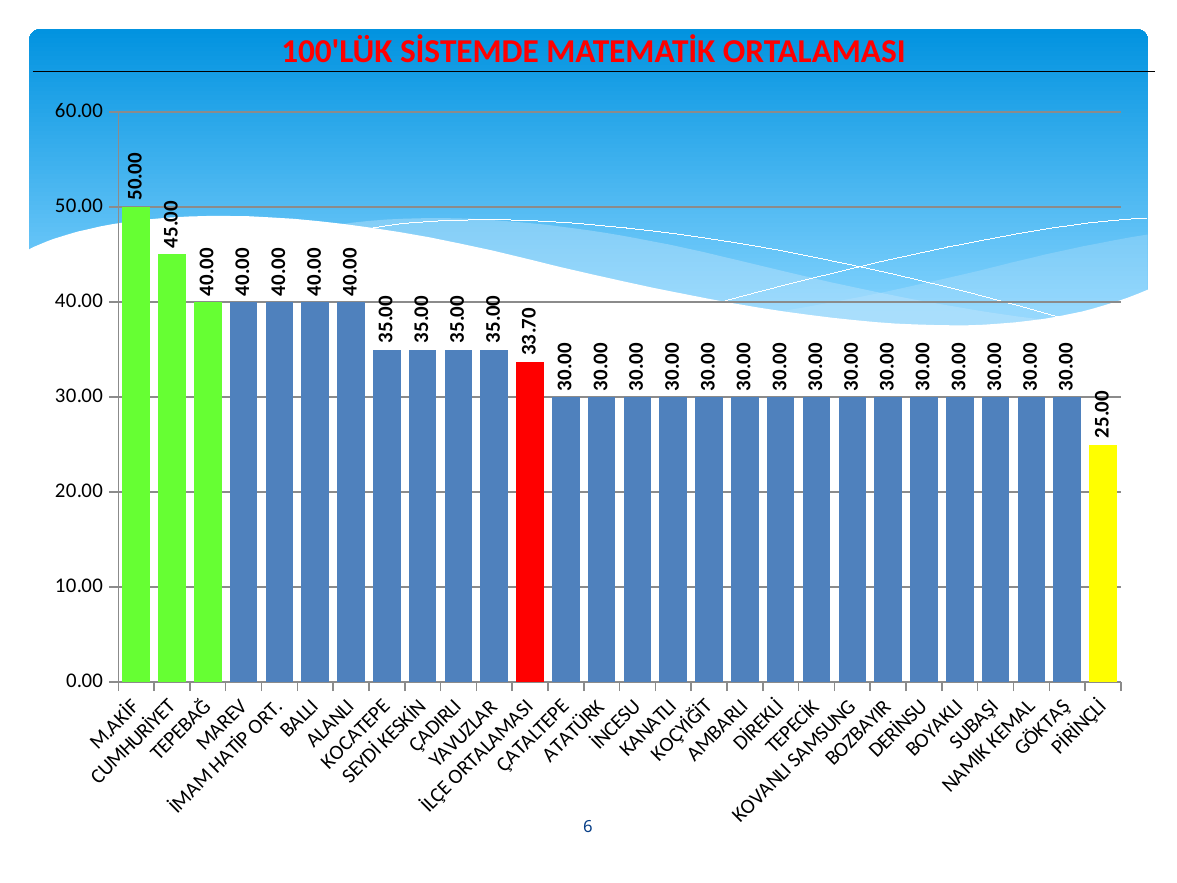
What is the value for M.AKİF? 50.00 How many categories are shown on the x axis? 28 What is the difference between the values for M.AKİF and CUMHURİYET? 5.00 What is the value for KOCATEPE? 35.00 What is the value for PİRİNÇLİ? 25.00 Which is larger, the value for TEPEBAĞ or the value for ÇADIRLI? TEPEBAĞ What is the value for İLÇE ORTALAMASI? 33.70 What is the difference between the values for İLÇE ORTALAMASI and PİRİNÇLİ? 8.70 What kind of chart is shown on the slide? bar chart Which category has the highest value? M.AKİF Which category has the lowest value? PİRİNÇLİ What is the title of the chart? 100'LÜK SİSTEMDE MATEMATİK ORTALAMASI